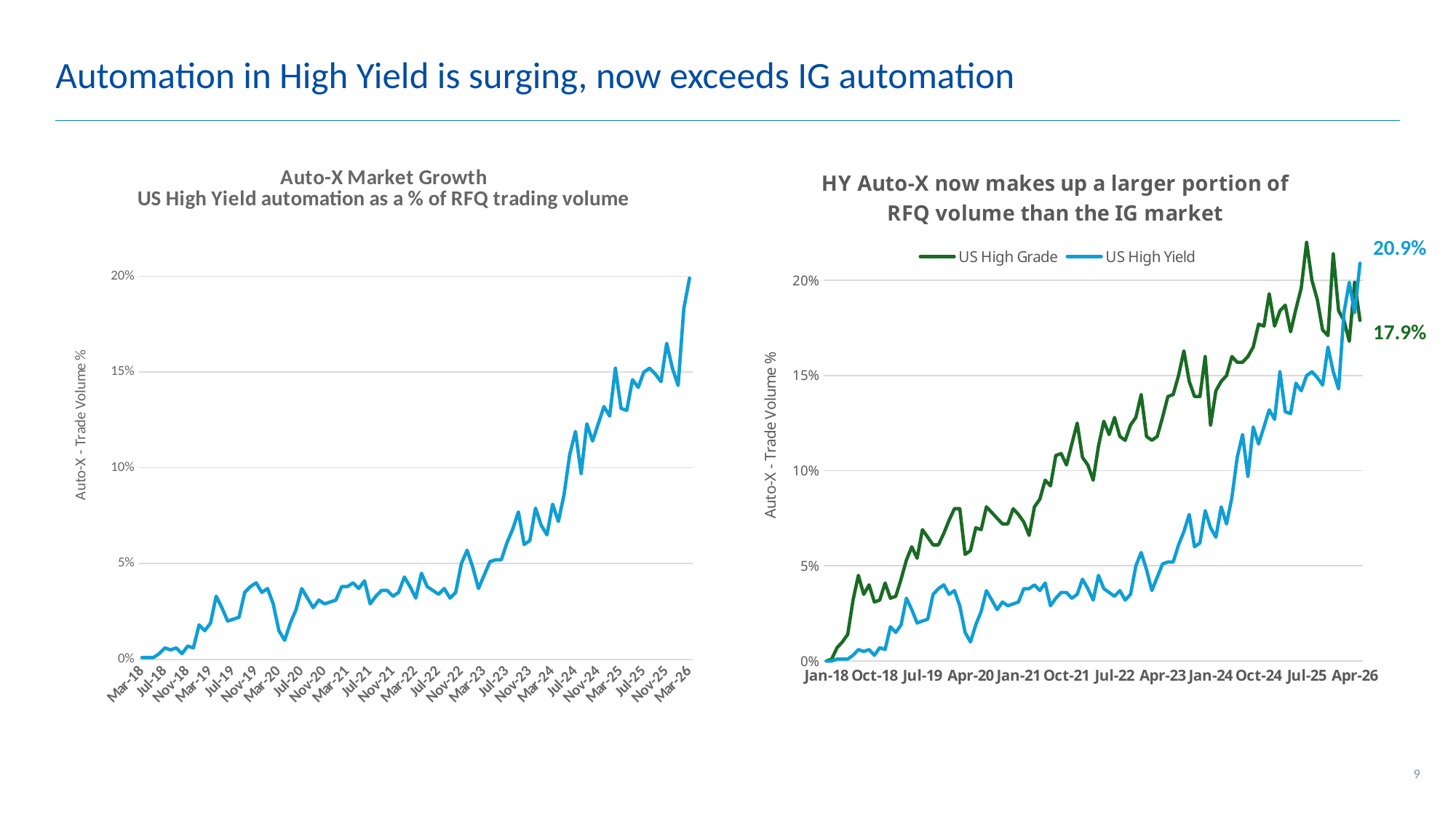
On the right chart, which series has the higher latest value, US High Grade or US High Yield? US High Yield What kind of chart is the left chart, titled 'Auto-X Market Growth'? Line chart On the right chart, how many series does the legend list? 2 On the left chart, is the value at Mar-26 greater or less than 15%? greater On the right chart, what is the difference between the latest US High Yield value and the latest US High Grade value? 3.0% On the left chart, is the value at Mar-20 greater or less than 5%? less On the right chart, what colour is the US High Yield line? Blue On the right chart, what is the latest value shown for US High Grade? 17.9% What kind of chart is the right chart? Line chart On the right chart, around Jan-21, which series is higher, US High Grade or US High Yield? US High Grade On the right chart, what is the latest value shown for US High Yield? 20.9% On the left chart, do the values generally rise or fall from Mar-18 to Mar-26? Rise